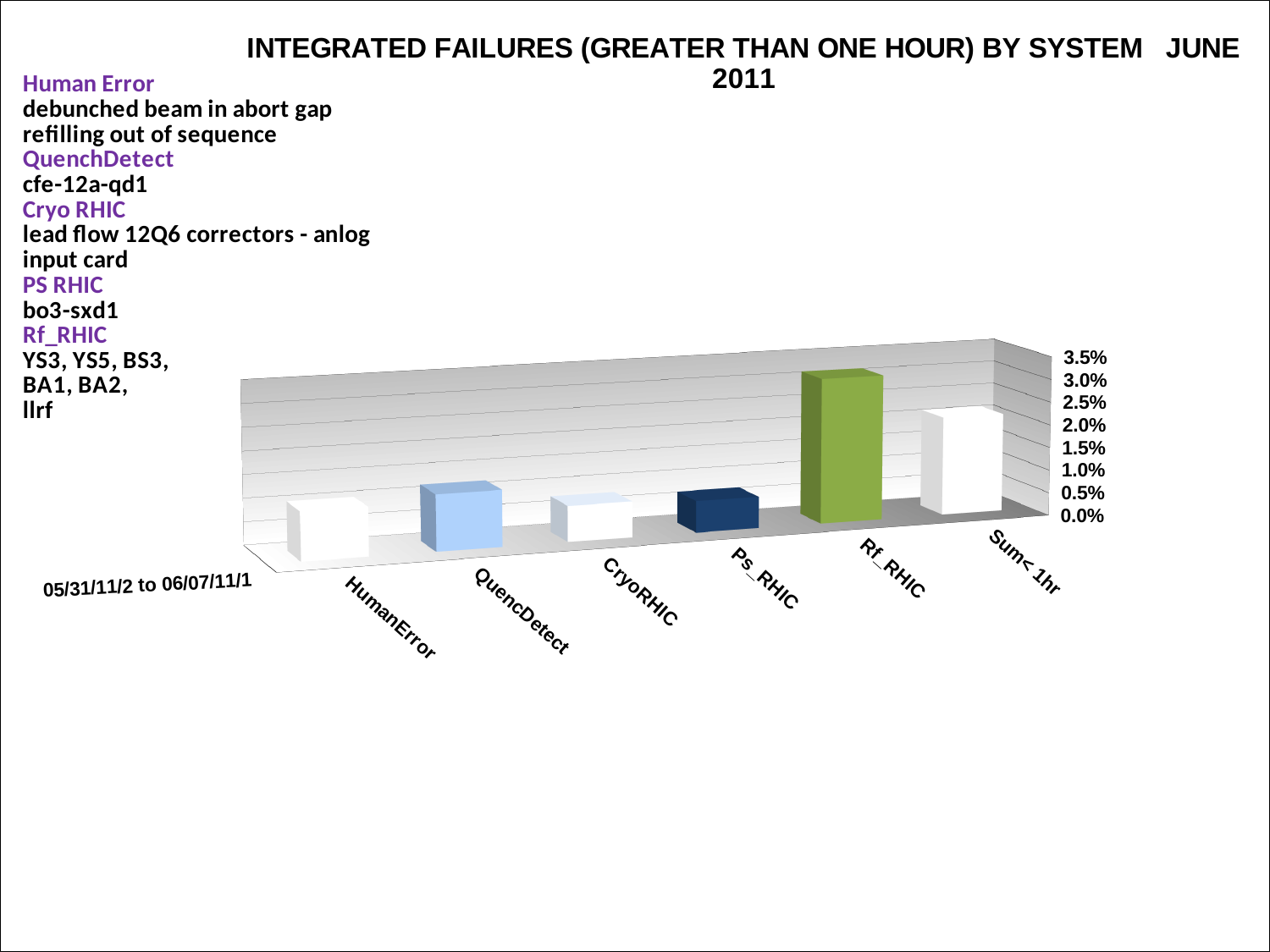
Is the value for Ps_RHIC greater or less than 1.0%? less Is the value for Rf_RHIC greater or less than 2.0%? greater What type of chart is shown on the slide? bar chart How many categories are plotted along the x axis of the chart? 6 Is the value for QuencDetect greater or less than 1.5%? less Which is larger, the value for Rf_RHIC or the value for Sum< 1hr? Rf_RHIC Which category has the highest value in the chart? Rf_RHIC What is the title of the chart? INTEGRATED FAILURES (GREATER THAN ONE HOUR) BY SYSTEM JUNE 2011 What date range is labelled at the bottom left of the chart? 05/31/11/2 to 06/07/11/1 Which is larger, the value for QuencDetect or the value for HumanError? QuencDetect